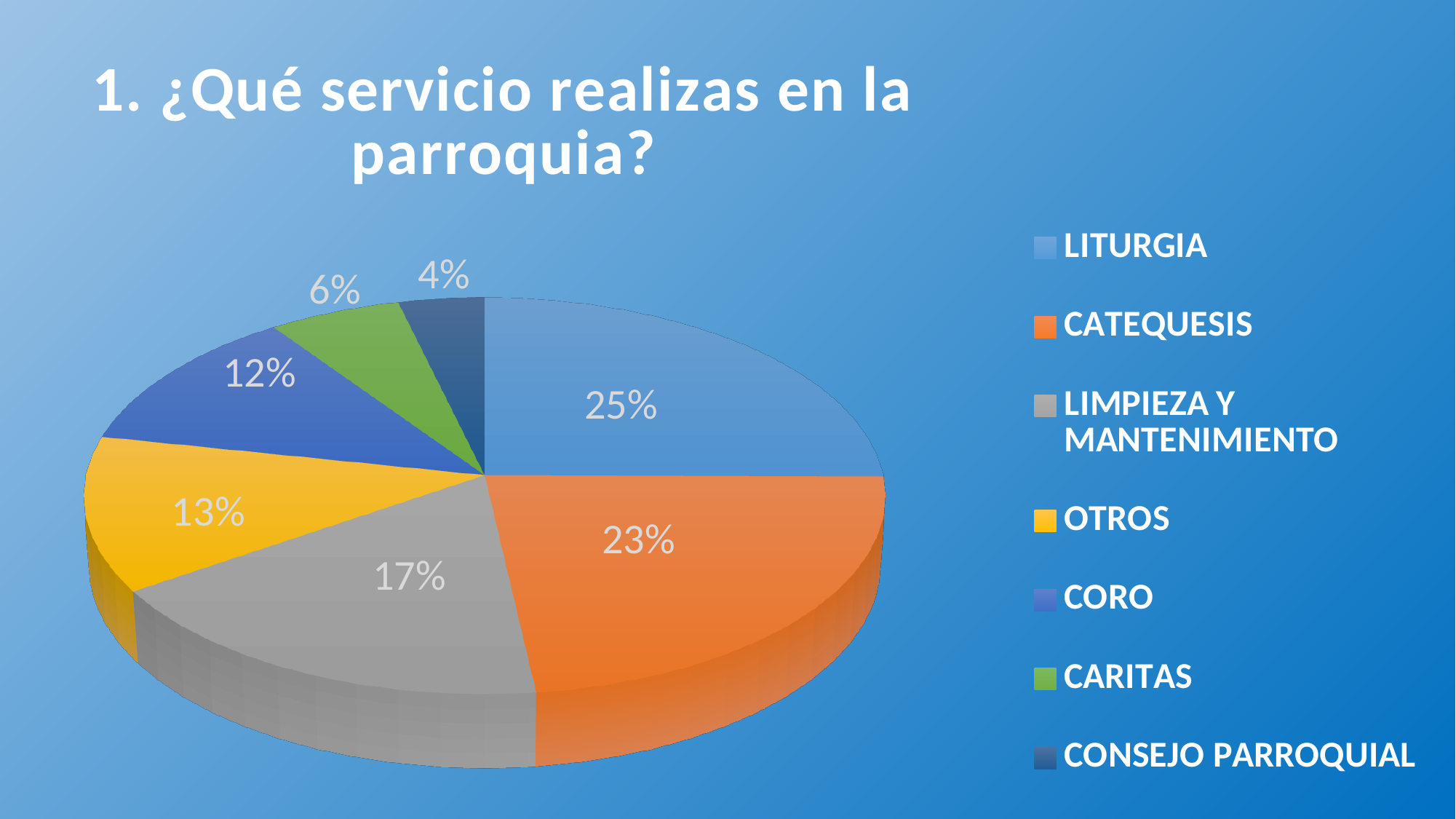
What kind of chart is shown on the slide? pie chart Which category has the largest share of the pie? LITURGIA What percentage of the pie corresponds to CORO? 12% What is the difference in percentage points between OTROS and CARITAS? 7 Which is larger, the share for CATEQUESIS or the share for LIMPIEZA Y MANTENIMIENTO? CATEQUESIS What colour is the CATEQUESIS slice? orange Which category has the smallest share of the pie? CONSEJO PARROQUIAL What percentage of the pie corresponds to LITURGIA? 25% What percentage of the pie corresponds to CONSEJO PARROQUIAL? 4% How many categories does the pie chart have? 7 What percentage of the pie corresponds to LIMPIEZA Y MANTENIMIENTO? 17% What percentage of the pie corresponds to CATEQUESIS? 23%